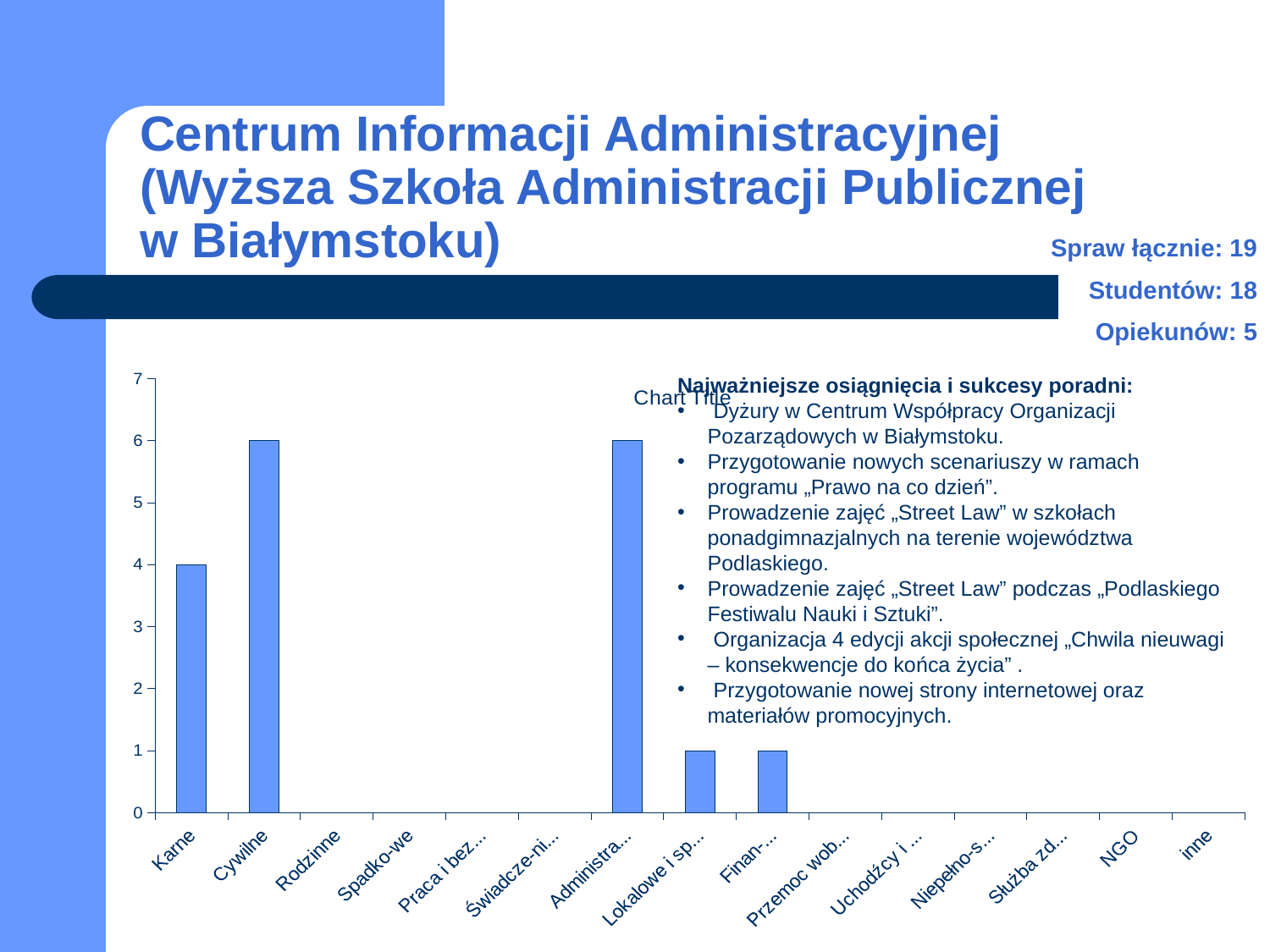
What is the value for Cywilne? 6 What kind of chart is shown on the slide? bar chart What is the difference between the values for Cywilne and Karne? 2 What is the title shown on the chart? Chart Title Which is larger, the value for Karne or the value for Cywilne? Cywilne Which is larger, the value for Karne or the value for Rodzinne? Karne What is the value for NGO? 0 What is the value for Rodzinne? 0 What is the value for Karne? 4 Is the value for Karne greater or less than 3? greater Is the value for Cywilne greater or less than 5? greater How many categories are shown on the x axis of the chart? 15